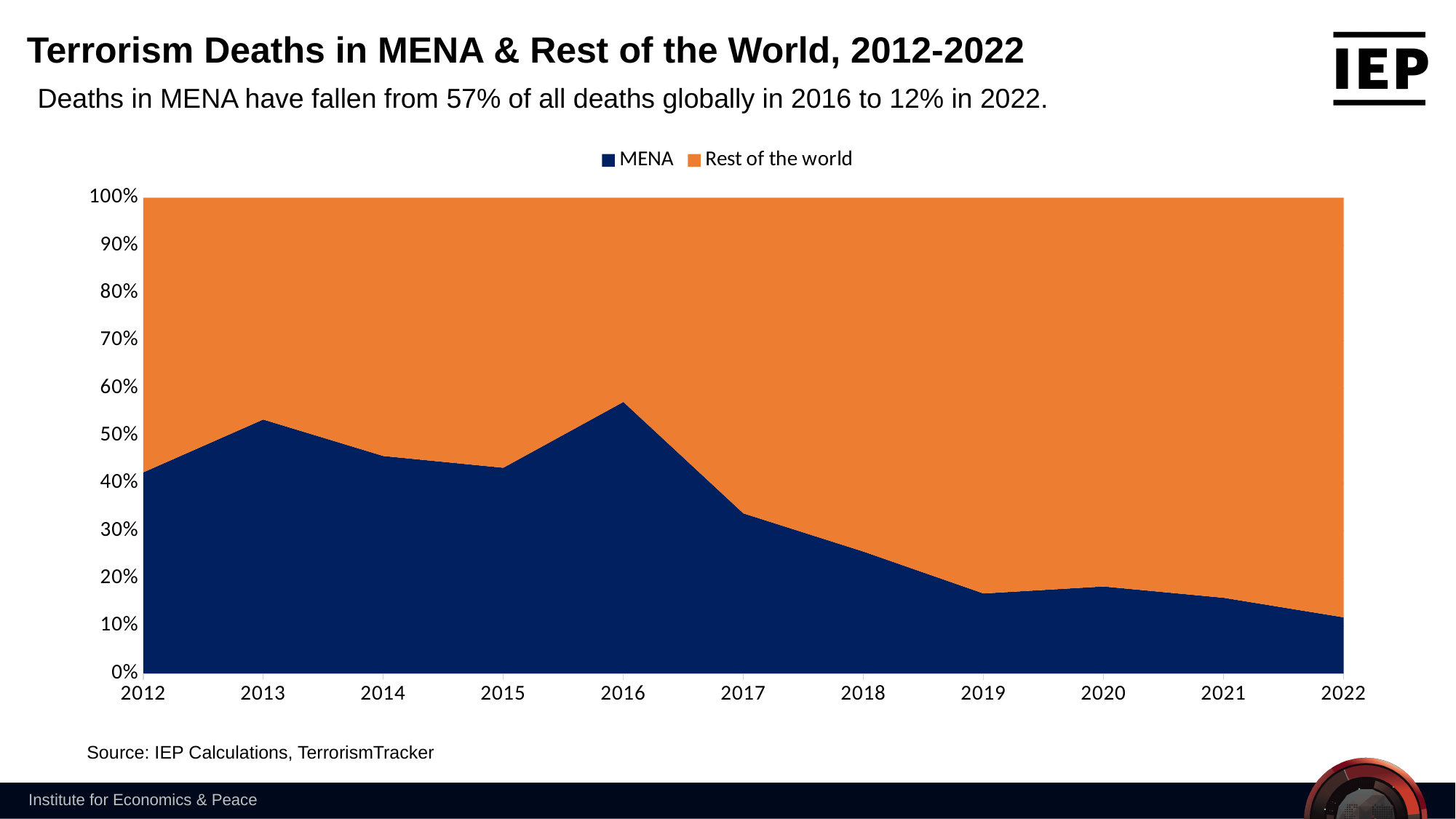
Is the MENA share in 2019 greater or less than 20%? less How many series does the legend list? 2 By how many percentage points did MENA's share of global terrorism deaths fall between 2016 and 2022? 45 percentage points Is the MENA share in 2012 greater or less than 50%? less What share of all terrorism deaths globally did MENA account for in 2022? 12% How many years are shown along the x axis? 11 In which year was MENA's share of global terrorism deaths highest? 2016 What share of all terrorism deaths globally did MENA account for in 2016? 57% Which year has a larger MENA share of terrorism deaths, 2014 or 2018? 2014 In which year was MENA's share of global terrorism deaths lowest? 2022 Does MENA's share of global terrorism deaths rise or fall from 2016 to 2022? Fall What kind of chart is shown on the slide? Stacked area chart